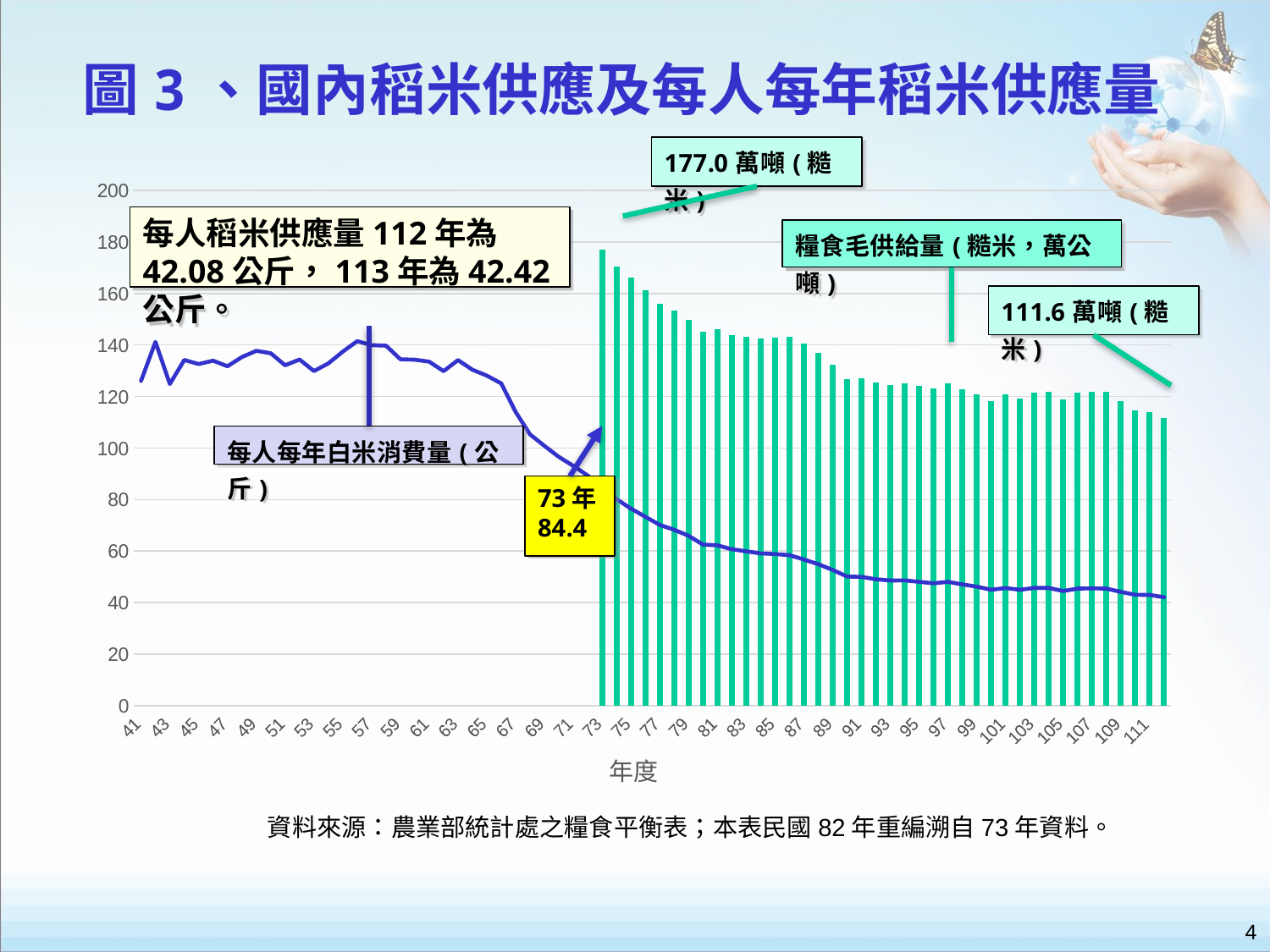
What is the title of the x axis? 年度 Is the gross food supply bar for year 75 greater or less than 160? greater According to the text box, what was the per-capita rice supply in year 112? 42.08 公斤 Does the per-capita white rice consumption line rise or fall from year 73 onward? Fall According to the text box, what was the per-capita rice supply in year 113? 42.42 公斤 What kind of chart is shown on the slide? A combined bar and line chart What is the difference between the labelled gross food supply of 177.0 萬噸 and 111.6 萬噸? 65.4 萬噸 What is the gross food supply (糧食毛供給量) labelled for the first bar, year 73? 177.0 萬噸 Is the per-capita white rice consumption value for year 111 greater or less than 60? less What is the per-capita white rice consumption (每人每年白米消費量) labelled for year 73? 84.4 What is the gross food supply labelled for the last bar on the right? 111.6 萬噸 Do the green bars rise or fall from year 73 to the right end of the x axis? Fall